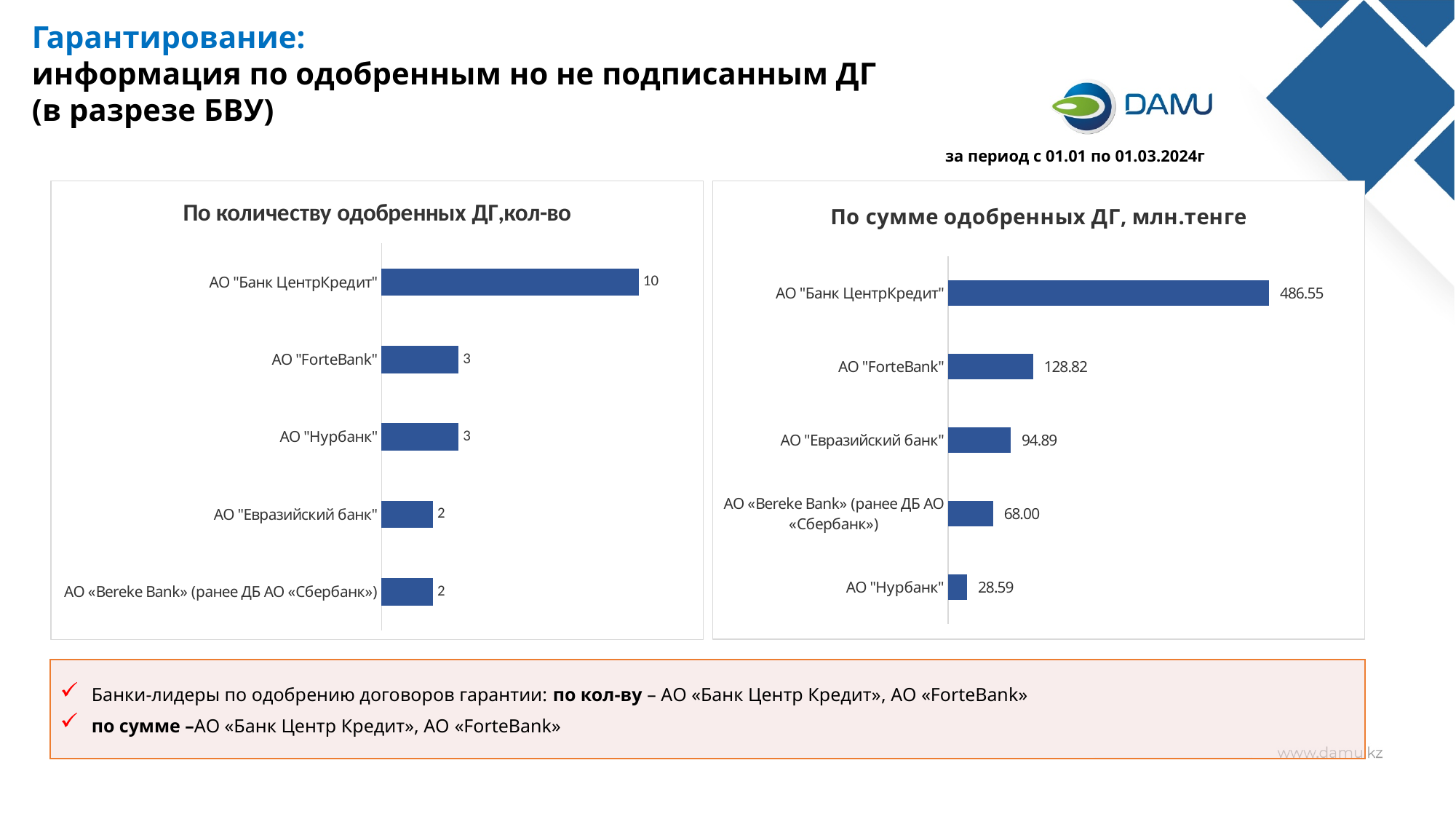
What type of chart is "По сумме одобренных ДГ, млн.тенге"? Bar chart In the chart "По сумме одобренных ДГ, млн.тенге", which bank has the lowest value? АО "Нурбанк" In the chart "По сумме одобренных ДГ, млн.тенге", what is the value for АО "Нурбанк"? 28.59 In the chart "По количеству одобренных ДГ,кол-во", what is the difference between АО "Банк ЦентрКредит" and АО "ForteBank"? 7 What is the title of the chart on the left side of the slide? По количеству одобренных ДГ,кол-во In the chart "По сумме одобренных ДГ, млн.тенге", which bank has the highest value? АО "Банк ЦентрКредит" How many banks are shown in the chart "По количеству одобренных ДГ,кол-во"? 5 In the chart "По сумме одобренных ДГ, млн.тенге", what is the value for АО "ForteBank"? 128.82 In the chart "По сумме одобренных ДГ, млн.тенге", what is the difference between АО "Евразийский банк" and АО «Bereke Bank» (ранее ДБ АО «Сбербанк»)? 26.89 In the chart "По количеству одобренных ДГ,кол-во", what is the value for АО "Банк ЦентрКредит"? 10 In the chart "По количеству одобренных ДГ,кол-во", what is the value for АО "Евразийский банк"? 2 In the chart "По сумме одобренных ДГ, млн.тенге", which is larger: the value for АО "ForteBank" or АО "Евразийский банк"? АО "ForteBank"